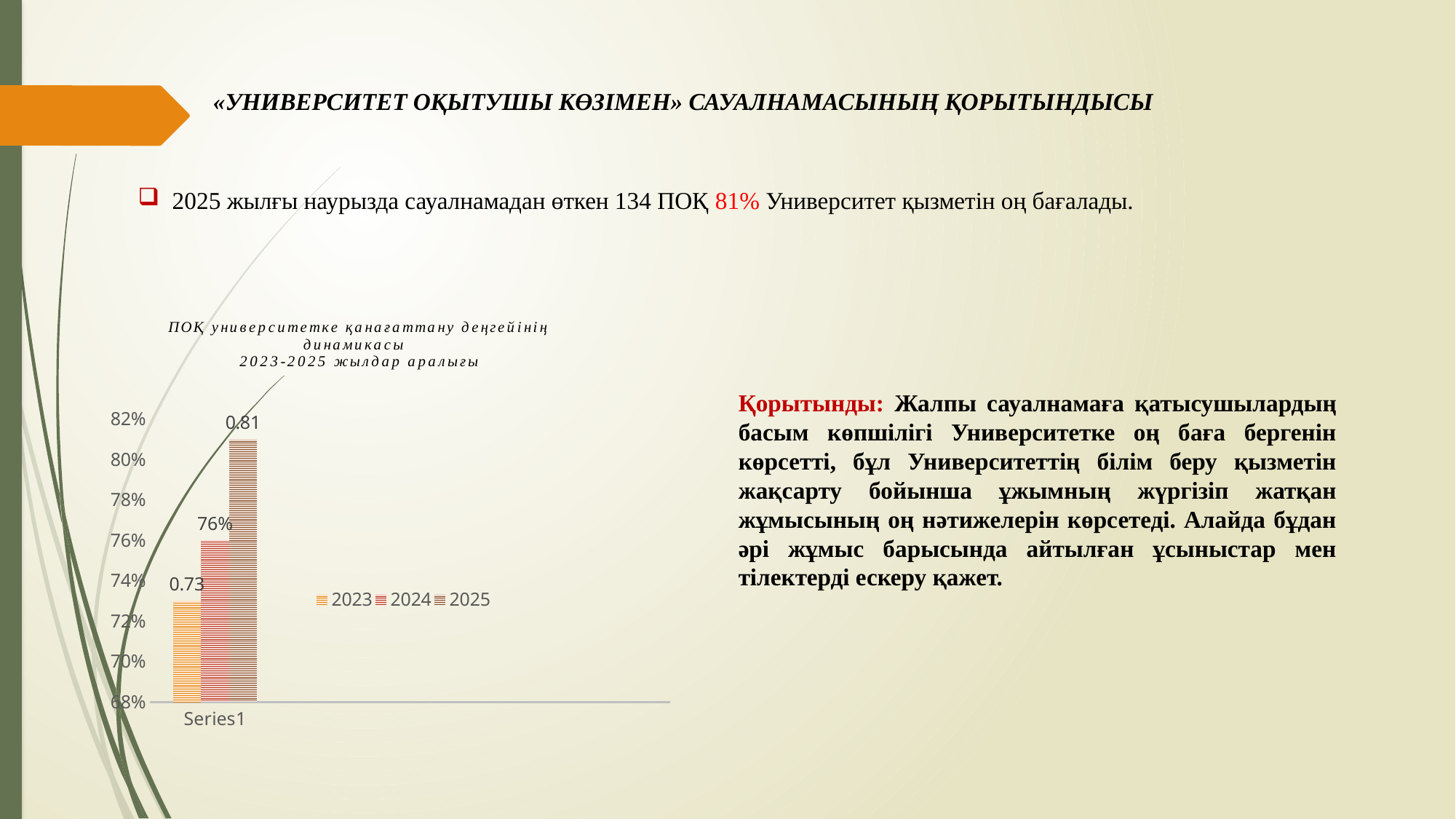
What is the value shown for 2023 in the chart? 0.73 Which year has the highest value in the chart? 2025 Which year has the lowest value in the chart? 2023 What is the value shown for 2025 in the chart? 0.81 Is the value for 2023 greater or less than 74%? less Is the value for 2025 greater or less than 80%? greater How many series does the chart legend list? 3 Which is larger, the value for 2024 or the value for 2023? 2024 What is the label of the category on the x axis of the chart? Series1 Do the values rise or fall from 2023 to 2025? rise What is the value shown for 2024 in the chart? 76% What kind of chart is shown on the slide? bar chart